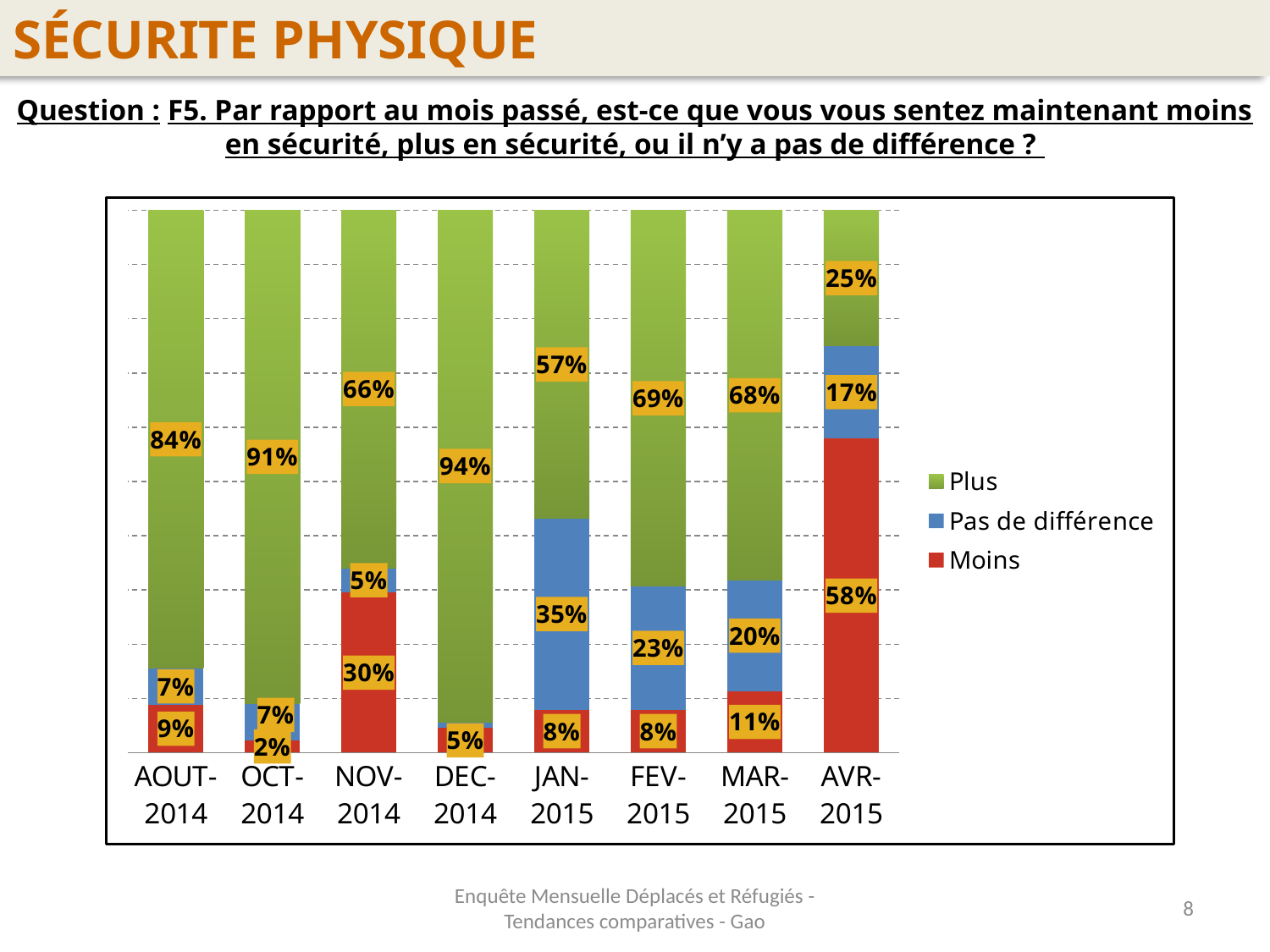
What is the difference between the 'Moins' values for NOV-2014 and OCT-2014? 28% What is the value of 'Moins' for AVR-2015? 58% Which is larger, the 'Pas de différence' value for FEV-2015 or for MAR-2015? FEV-2015 What kind of chart is shown on the slide? stacked bar chart Which series is shown in red in the legend? Moins What is the value of 'Pas de différence' for JAN-2015? 35% How many months (categories) are shown on the x axis? 8 How many series does the legend list? 3 Which month has the highest 'Plus' value? DEC-2014 What is the value of 'Plus' for DEC-2014? 94% Which month has the lowest 'Plus' value? AVR-2015 What is the total of the stacked bar for AOUT-2014? 100%